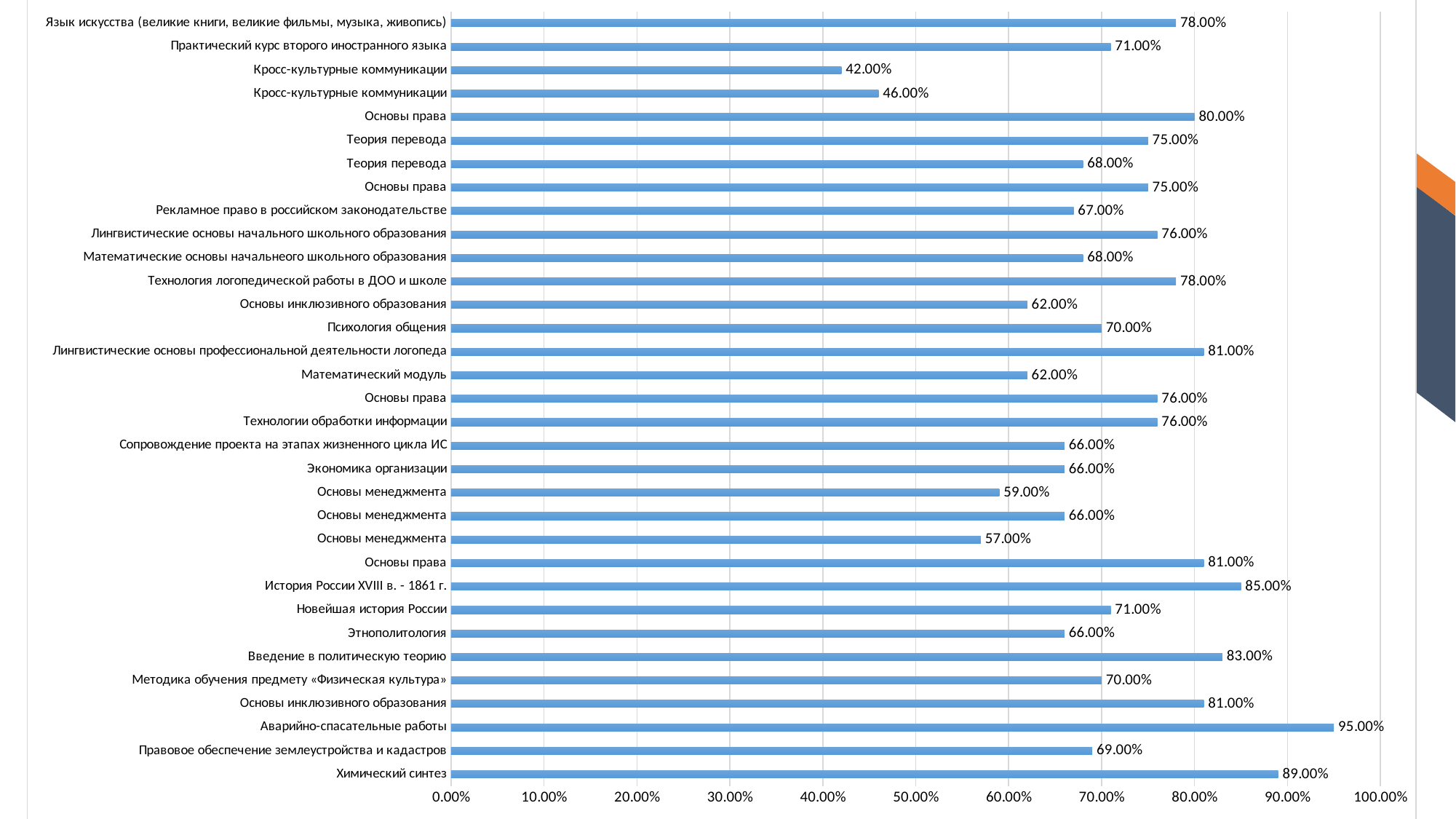
What is the lowest value shown in the chart? 42.00% Which category has the highest value? Аварийно-спасательные работы What is the difference between the values for Язык искусства (великие книги, великие фильмы, музыка, живопись) and Практический курс второго иностранного языка? 7.00% What is the value for Химический синтез? 89.00% What is the value for Психология общения? 70.00% What kind of chart is shown on the slide? bar chart What is the difference between the values for Аварийно-спасательные работы and Химический синтез? 6.00% What is the maximum value shown on the horizontal axis? 100.00% What is the value for Математический модуль? 62.00% What is the value for История России XVIII в. - 1861 г.? 85.00% Which has a larger value, Введение в политическую теорию or Этнополитология? Введение в политическую теорию How many bars are plotted in the chart? 33